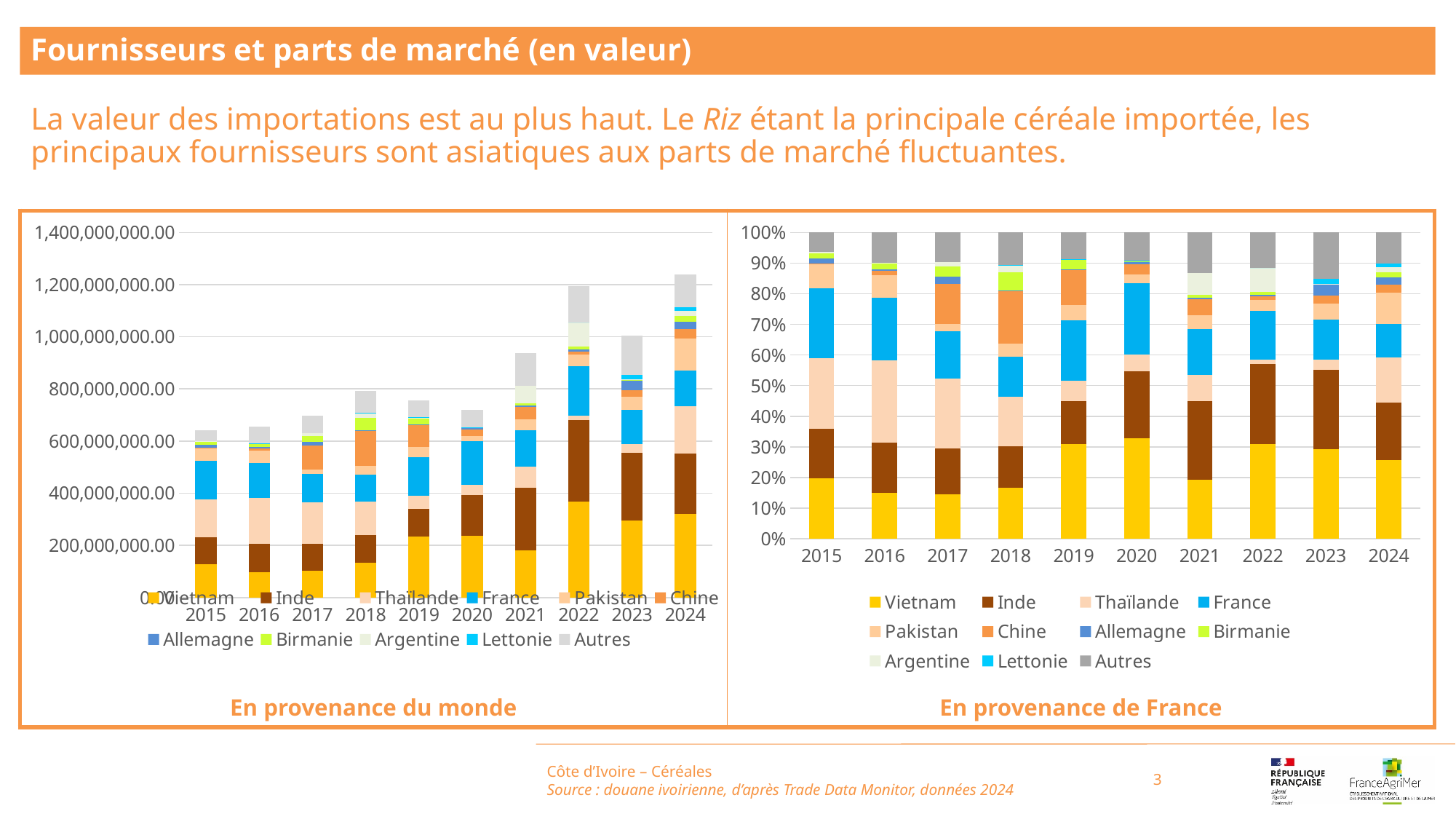
In the 'En provenance du monde' chart, is the total bar for 2021 greater or less than 800,000,000.00? greater In the 'En provenance du monde' chart, is the total bar for 2015 greater or less than 800,000,000.00? less In the 'En provenance de France' chart, is the Vietnam share larger in 2019 or in 2016? 2019 What kind of chart is the 'En provenance de France' chart on the right? 100% stacked bar chart In the 'En provenance du monde' chart, which legend entry is shown in yellow? Vietnam In the 'En provenance du monde' chart, is the Vietnam segment for 2024 greater or less than 200,000,000.00? greater What kind of chart is the 'En provenance du monde' chart on the left? stacked bar chart In the 'En provenance de France' chart, how many series does the legend list? 11 In the 'En provenance du monde' chart, how many years are shown on the x axis? 10 In the 'En provenance du monde' chart, which year has the highest total bar? 2024